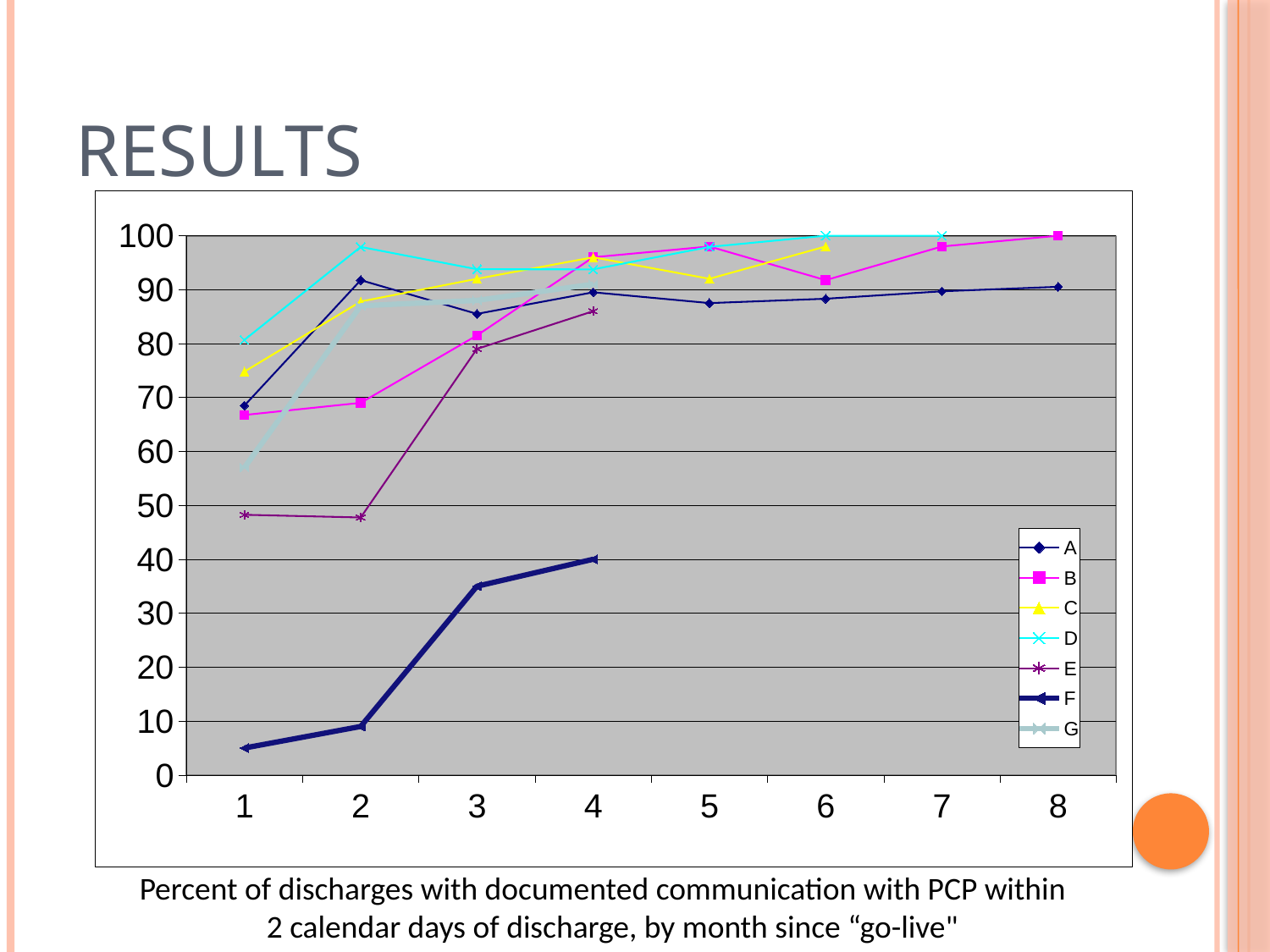
Is the value for series B at month 8 greater or less than 90? greater Is the value for series F at month 1 greater or less than 10? less How many months are shown along the x axis? 8 Does the value for series F rise or fall from month 1 to month 4? rise How many series does the legend list? 7 How many data points are plotted for series F? 4 At month 4, which series has the larger value, E or F? E Is the value for series E at month 3 greater or less than 70? greater Which series has the lowest value at month 1? F Which series has the highest value at month 1? D What kind of chart is shown on the slide? line chart